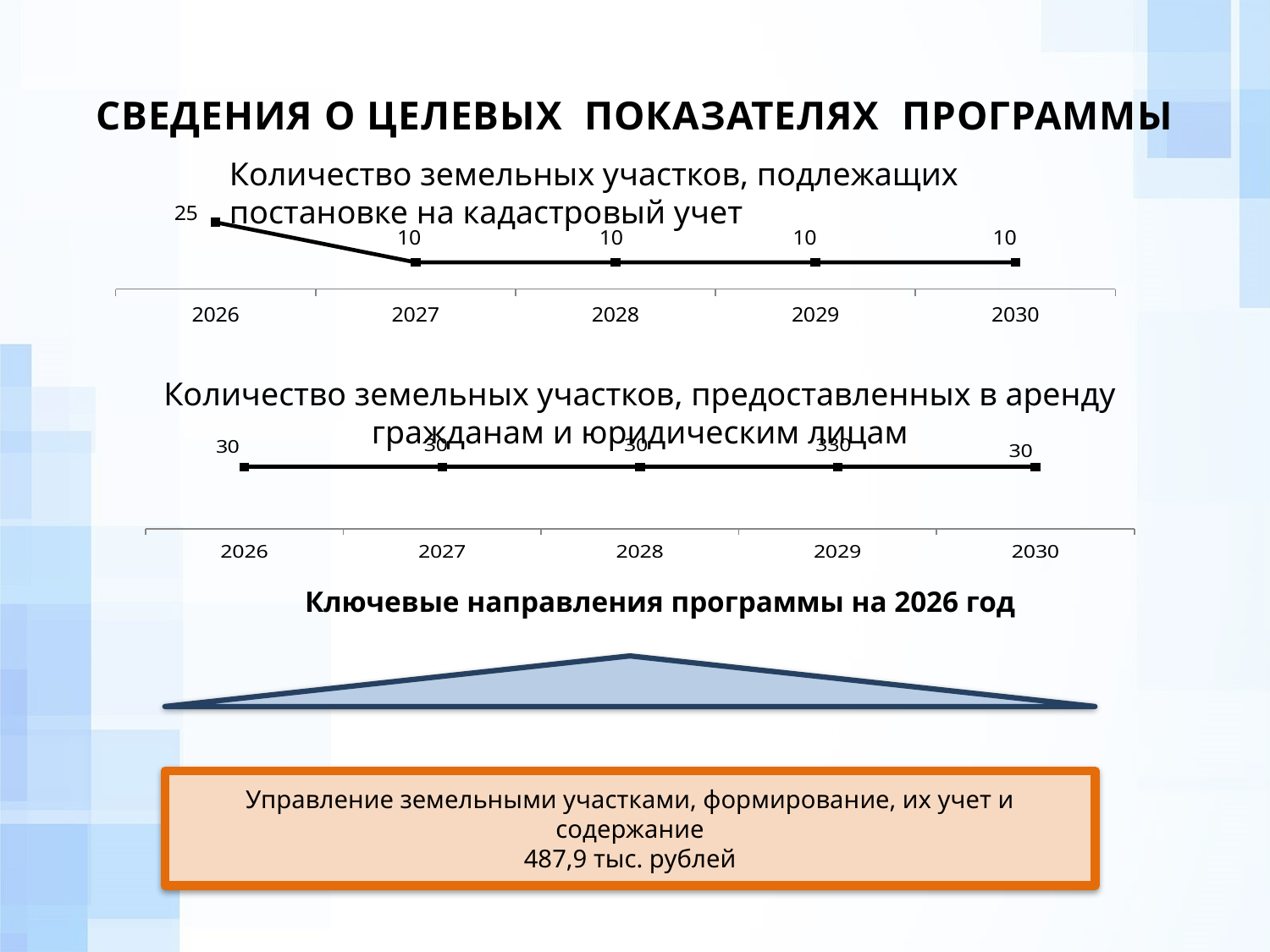
In the chart 'Количество земельных участков, подлежащих постановке на кадастровый учет', what is the difference between the values for 2026 and 2027? 15 In the chart 'Количество земельных участков, подлежащих постановке на кадастровый учет', what is the value for 2028? 10 What is the first year shown on the x axis of the chart 'Количество земельных участков, предоставленных в аренду гражданам и юридическим лицам'? 2026 In the chart 'Количество земельных участков, предоставленных в аренду гражданам и юридическим лицам', what is the value for 2026? 30 In the chart 'Количество земельных участков, подлежащих постановке на кадастровый учет', which is larger, the value for 2026 or the value for 2030? 2026 What kind of chart is 'Количество земельных участков, подлежащих постановке на кадастровый учет'? line chart In the chart 'Количество земельных участков, предоставленных в аренду гражданам и юридическим лицам', do the values rise, fall or stay flat from 2026 to 2030? stay flat In the chart 'Количество земельных участков, подлежащих постановке на кадастровый учет', what is the value for 2026? 25 In the chart 'Количество земельных участков, предоставленных в аренду гражданам и юридическим лицам', what is the value for 2030? 30 How many years are plotted in the chart 'Количество земельных участков, подлежащих постановке на кадастровый учет'? 5 In the chart 'Количество земельных участков, подлежащих постановке на кадастровый учет', which year has the highest value? 2026 In the chart 'Количество земельных участков, подлежащих постановке на кадастровый учет', do the values rise or fall from 2026 to 2027? fall